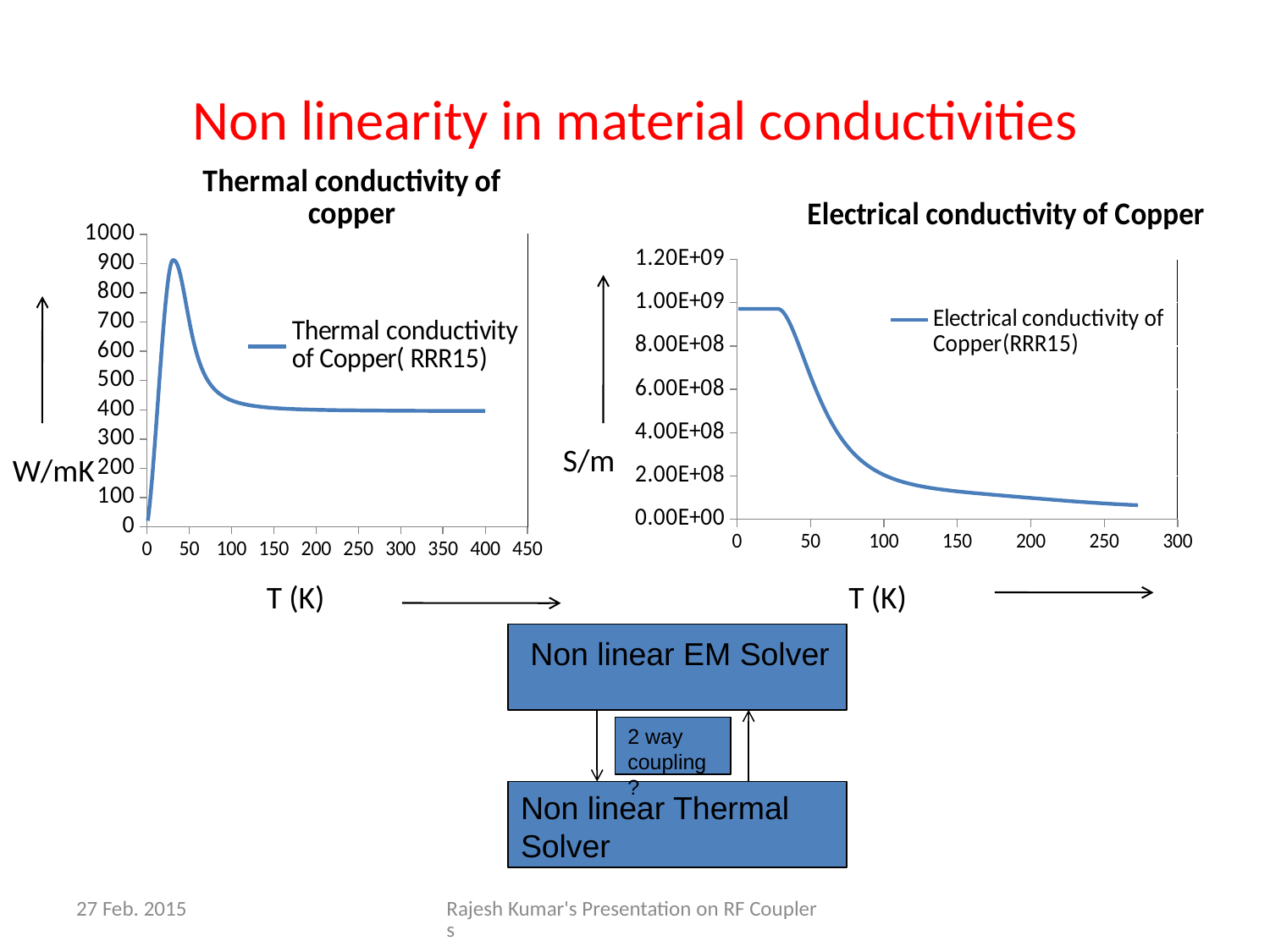
In the 'Thermal conductivity of copper' chart, is the peak value of the thermal conductivity greater or less than 800? greater How many series does the legend of the 'Electrical conductivity of Copper' chart list? 1 In the 'Thermal conductivity of copper' chart, what is the legend entry for the plotted series? Thermal conductivity of Copper( RRR15) What type of chart is the 'Thermal conductivity of copper' chart? line chart In the 'Electrical conductivity of Copper' chart, what is the legend entry for the plotted series? Electrical conductivity of Copper(RRR15) How many series does the legend of the 'Thermal conductivity of copper' chart list? 1 In the 'Electrical conductivity of Copper' chart, is the electrical conductivity at 250 K greater or less than 2.00E+08? less In the 'Electrical conductivity of Copper' chart, does the electrical conductivity rise or fall as temperature increases from 50 K to 250 K? fall In the 'Thermal conductivity of copper' chart, does the thermal conductivity rise or fall as temperature increases from 50 K to 150 K? fall What type of chart is the 'Electrical conductivity of Copper' chart? line chart In the 'Thermal conductivity of copper' chart, is the thermal conductivity at 400 K greater or less than 500? less